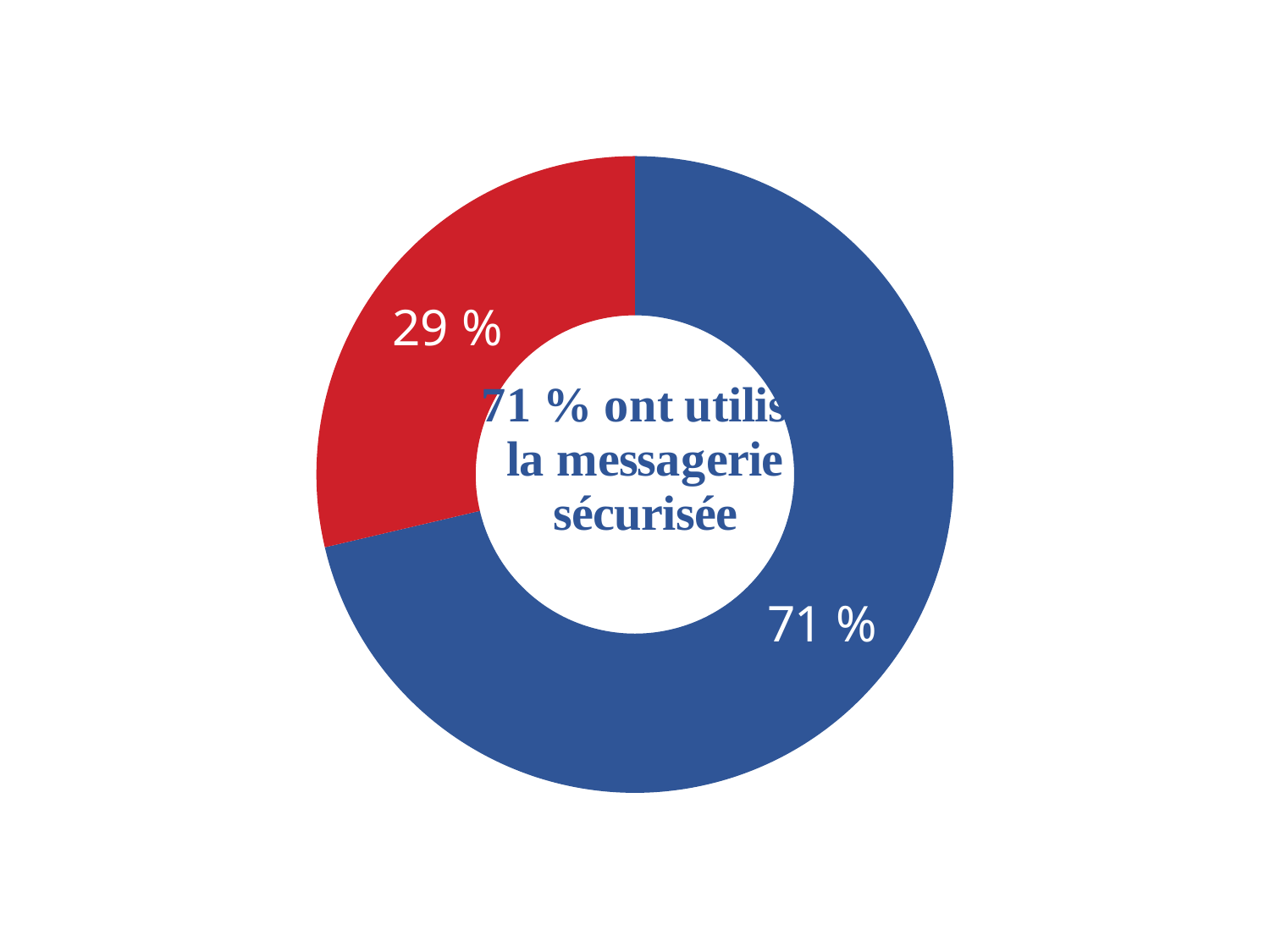
How many slices does the doughnut chart have? 2 According to the text in the centre of the doughnut chart, what percentage used the secure messaging service (messagerie sécurisée)? 71 % Which is larger in the doughnut chart, the blue slice or the red slice? the blue slice What colour is the slice representing 29 % in the doughnut chart? red What value is shown on the red slice of the doughnut chart? 29 % Which slice of the doughnut chart is the largest? the blue slice (71 %) What share of the doughnut chart does the blue slice represent? 71 % Which slice of the doughnut chart is the smallest? the red slice (29 %) What is the difference between the blue slice and the red slice of the doughnut chart? 42 % What kind of chart is shown on the slide? doughnut chart What share of the doughnut chart does the red slice represent? 29 % What value is shown on the blue slice of the doughnut chart? 71 %